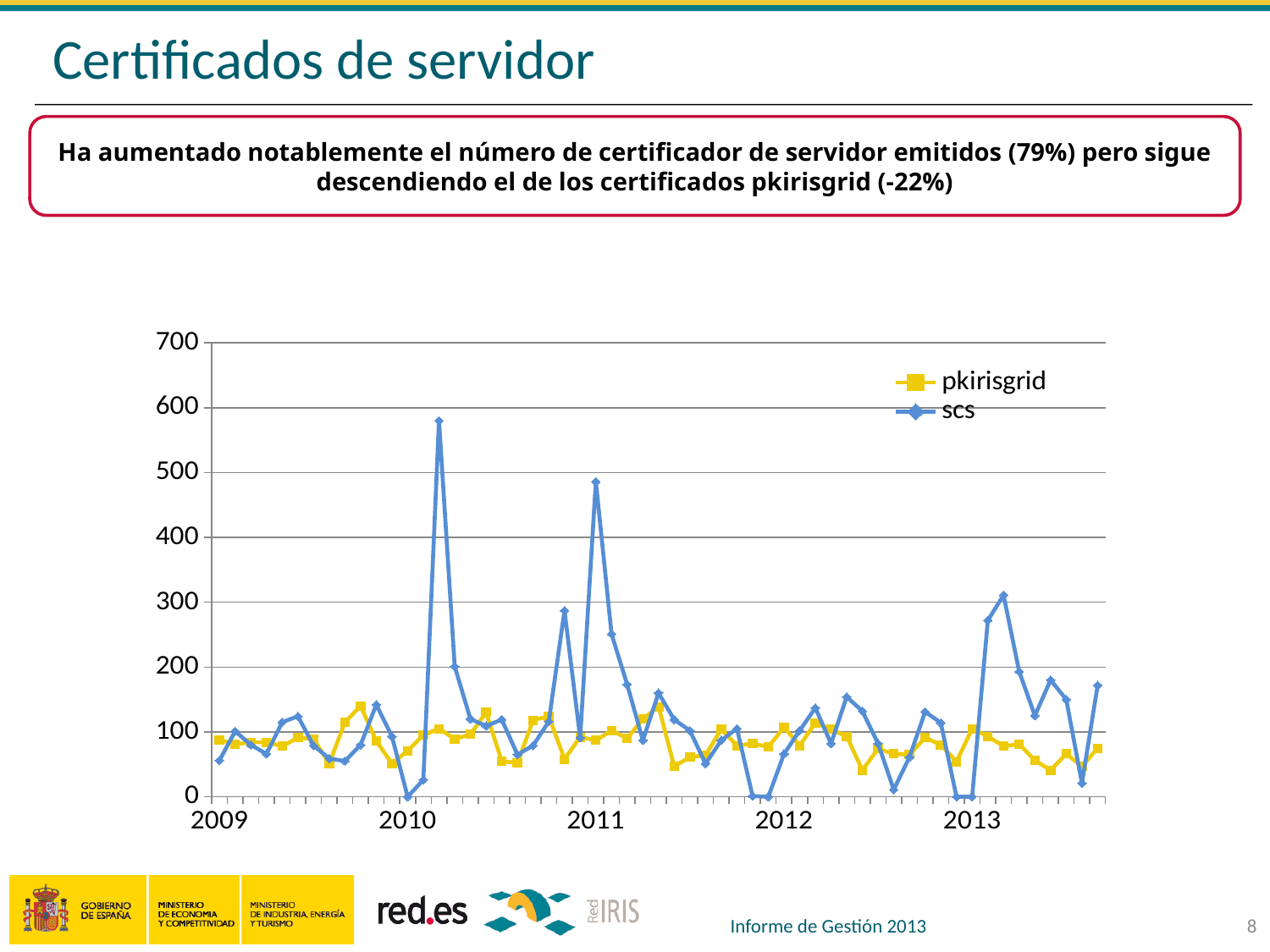
How many series does the chart legend list? 2 What is the highest value shown on the y axis? 700 How many year labels are shown on the x axis? 5 Which series is drawn in blue with diamond markers? scs What are the names of the two series in the chart legend? pkirisgrid and scs What kind of chart is shown on the slide? line chart Which series reaches the highest value anywhere on the chart? scs At the 2010 tick on the x axis, which series has the larger value, pkirisgrid or scs? pkirisgrid Is the peak of the scs series near the start of 2011 greater or less than 400? greater Is the peak of the scs series in early 2013 greater or less than 200? greater Is the highest peak of the scs series, shortly after 2010, greater or less than 500? greater